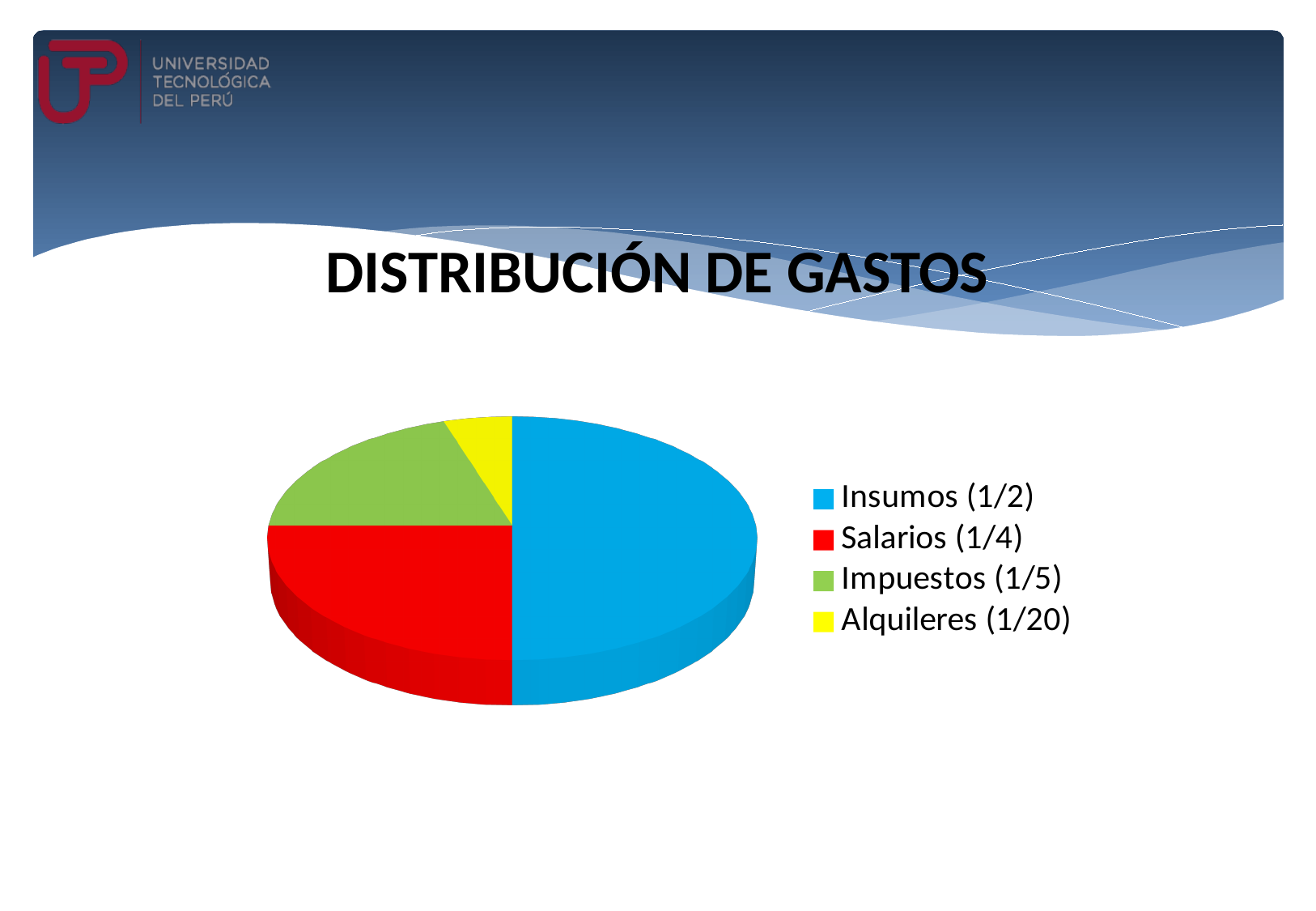
What kind of chart is shown on the slide? pie chart What share of the pie does Alquileres represent? 1/20 What share of the pie does Impuestos represent? 1/5 Which is larger, the slice for Salarios or the slice for Impuestos? Salarios What share of the pie does Insumos represent? 1/2 Which colour is used for the Impuestos slice? green How many slices does the pie chart have? 4 Which is larger, the slice for Impuestos or the slice for Alquileres? Impuestos What is the title of the chart? DISTRIBUCIÓN DE GASTOS Which category has the smallest slice of the pie? Alquileres Which category has the largest slice of the pie? Insumos